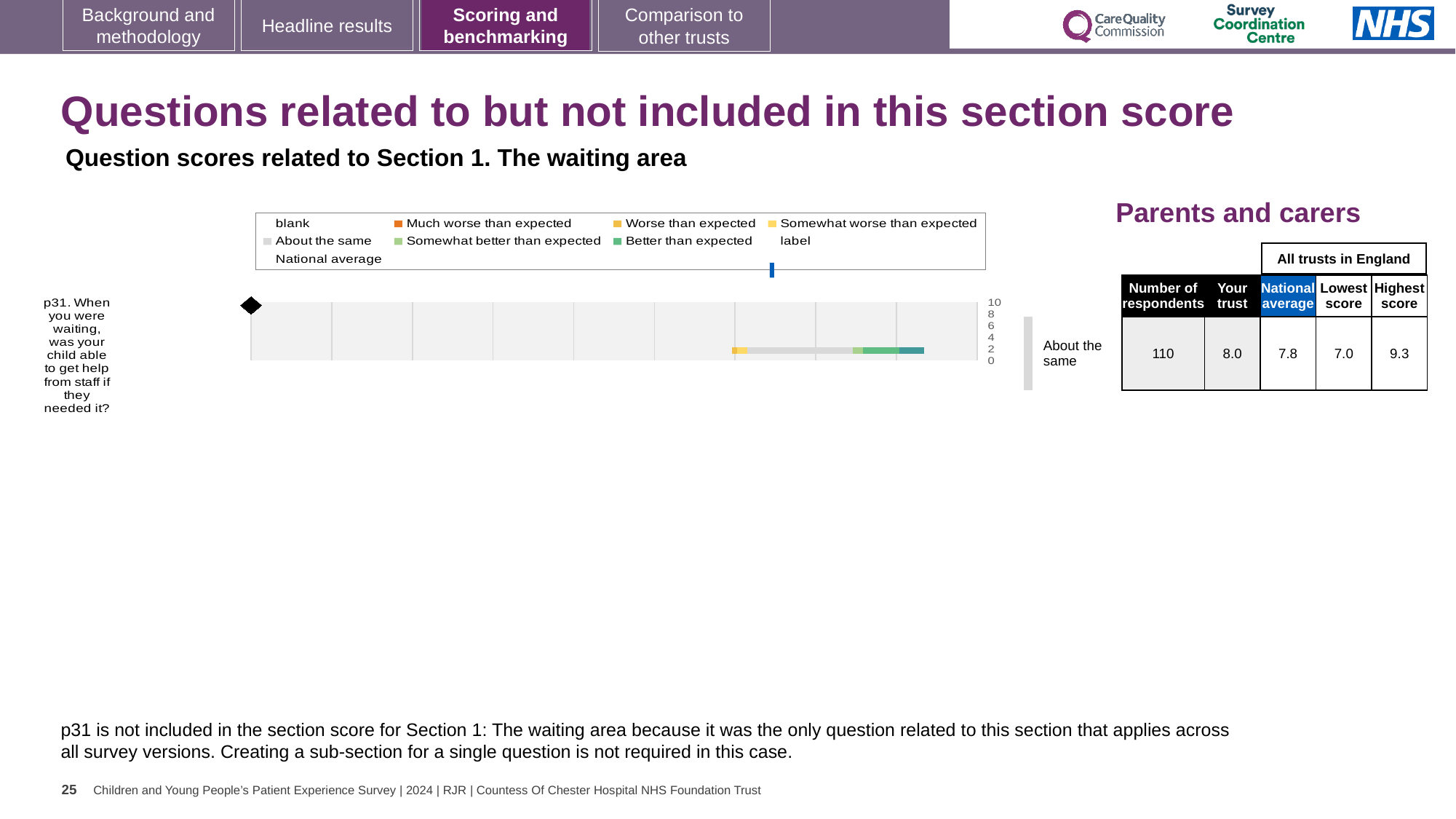
In the Parents and carers table, what is the 'Your trust' score for p31? 8.0 How many questions (categories) are plotted in the chart? 1 What is the highest value shown on the chart's numeric axis? 10 Which is larger for p31, the 'Your trust' score or the National average? Your trust In the Parents and carers table, what is the lowest score among all trusts in England for p31? 7.0 What colour does the legend use for 'Much worse than expected'? orange In the Parents and carers table, what is the National average score for p31? 7.8 What is the difference between the highest score and the lowest score for p31 in the table? 2.3 What benchmark category label is shown next to the bar for p31? About the same In the Parents and carers table, what is the number of respondents for p31? 110 In the Parents and carers table, what is the highest score among all trusts in England for p31? 9.3 What kind of chart is shown on the slide for question p31? bar chart